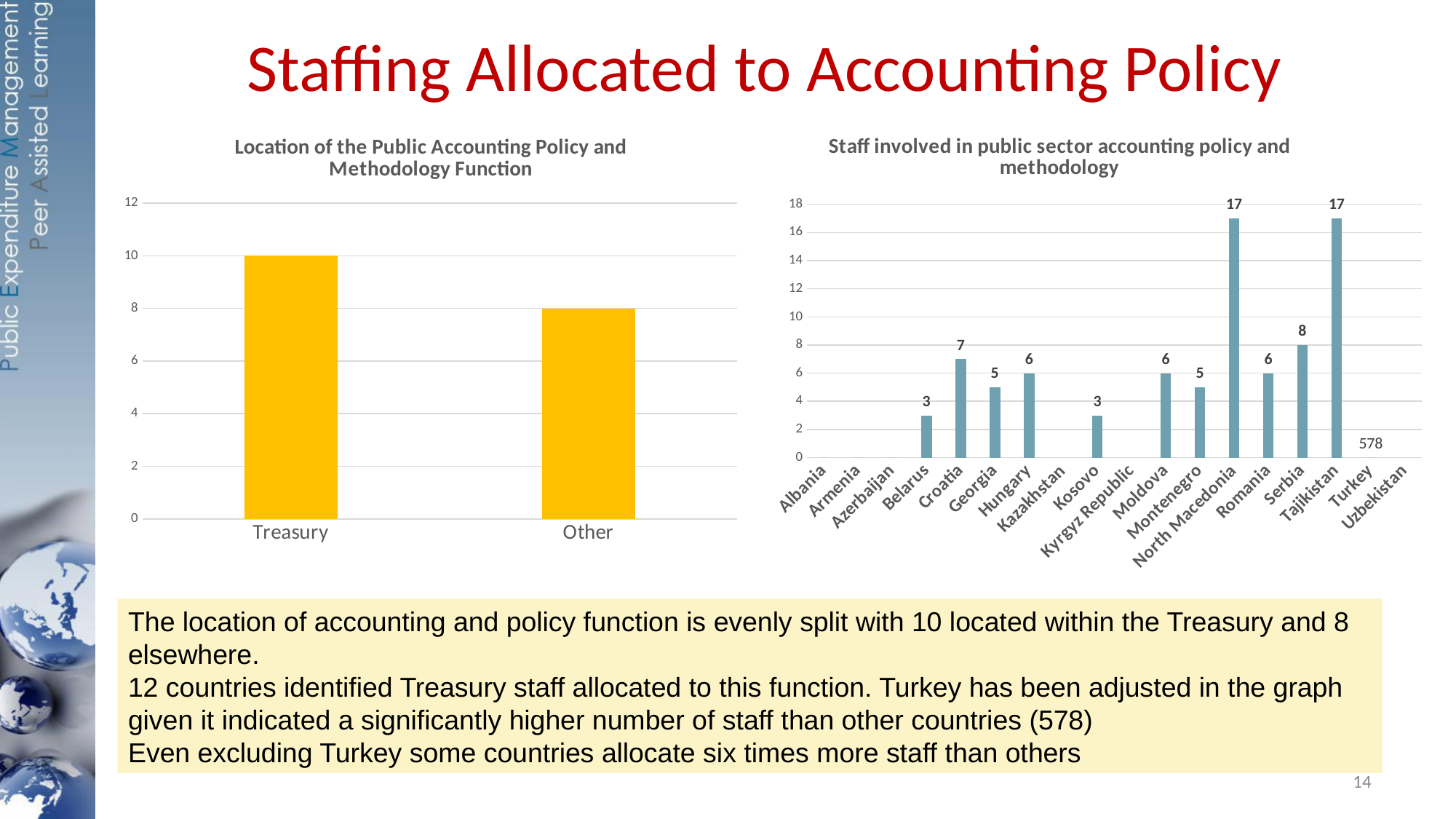
In the chart titled "Location of the Public Accounting Policy and Methodology Function", what is the difference between the Treasury and Other values? 2 What is the title of the chart on the right of the slide? Staff involved in public sector accounting policy and methodology In the chart titled "Staff involved in public sector accounting policy and methodology", what is the value for Croatia? 7 In the chart titled "Location of the Public Accounting Policy and Methodology Function", what is the value for Other? 8 In the chart titled "Staff involved in public sector accounting policy and methodology", what value is labelled for Turkey? 578 In the chart titled "Staff involved in public sector accounting policy and methodology", what is the difference between the values for Serbia and Belarus? 5 What kind of chart is the chart on the left of the slide? Bar chart In the chart titled "Staff involved in public sector accounting policy and methodology", which is larger, the value for Hungary or the value for Georgia? Hungary In the chart titled "Staff involved in public sector accounting policy and methodology", which two countries have a labelled value of 17? North Macedonia and Tajikistan In the chart titled "Location of the Public Accounting Policy and Methodology Function", what is the value for Treasury? 10 How many countries are listed on the x axis of the chart titled "Staff involved in public sector accounting policy and methodology"? 18 In the chart titled "Staff involved in public sector accounting policy and methodology", what is the value for Serbia? 8